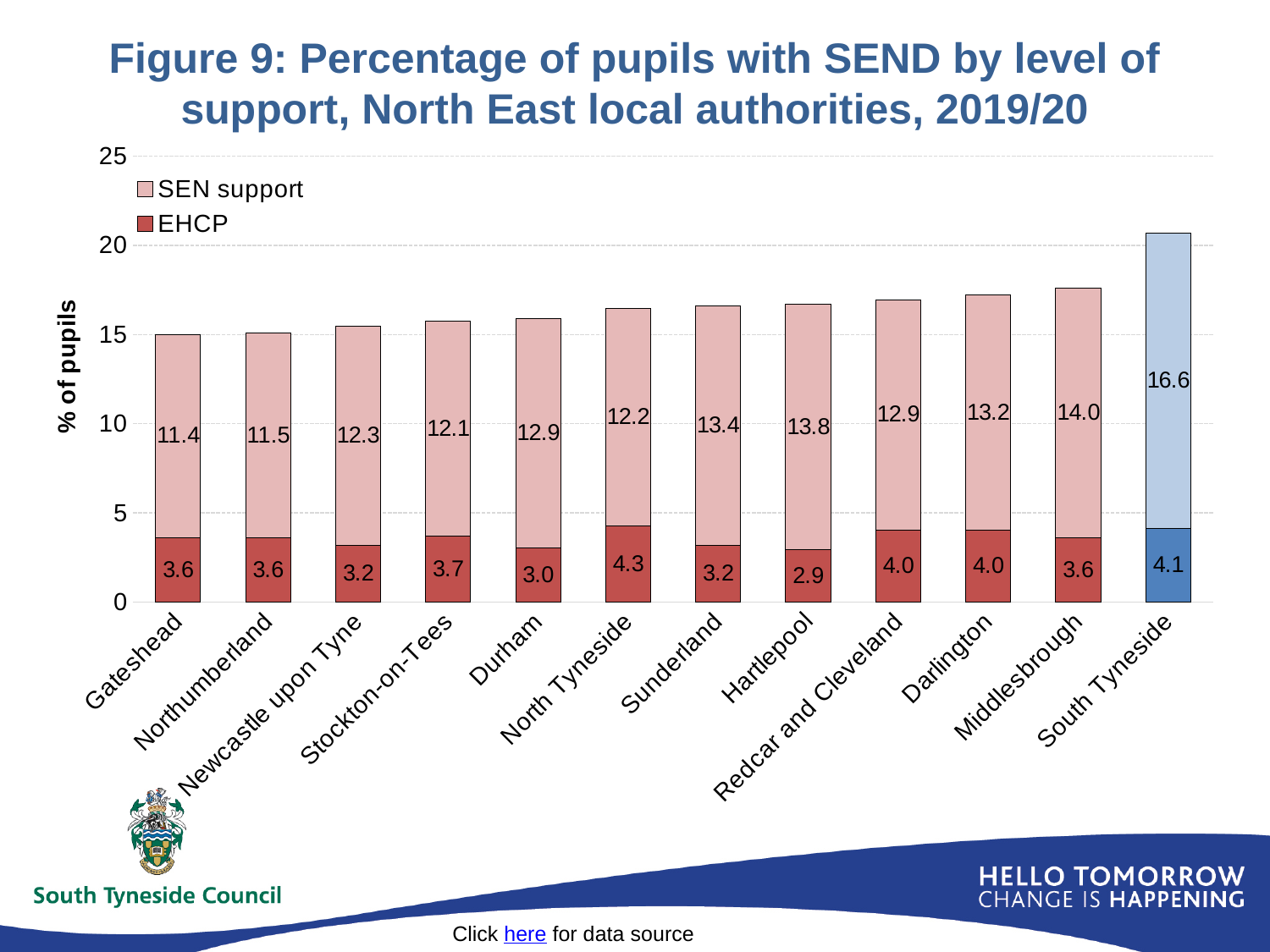
Which has a larger EHCP value, Stockton-on-Tees or Sunderland? Stockton-on-Tees How many local authorities are shown on the chart? 12 How many series does the legend list? 2 What is the total height of the stacked bar for Gateshead? 15.0 What kind of chart is shown on the slide? Stacked bar chart What is the total height of the stacked bar for South Tyneside? 20.7 What is the EHCP value for Hartlepool? 2.9 What is the difference between the SEN support values for Middlesbrough and Gateshead? 2.6 Which local authority has the lowest SEN support value? Gateshead Which local authority has the highest EHCP value? North Tyneside What is the SEN support value for Durham? 12.9 What is the SEN support value for South Tyneside? 16.6